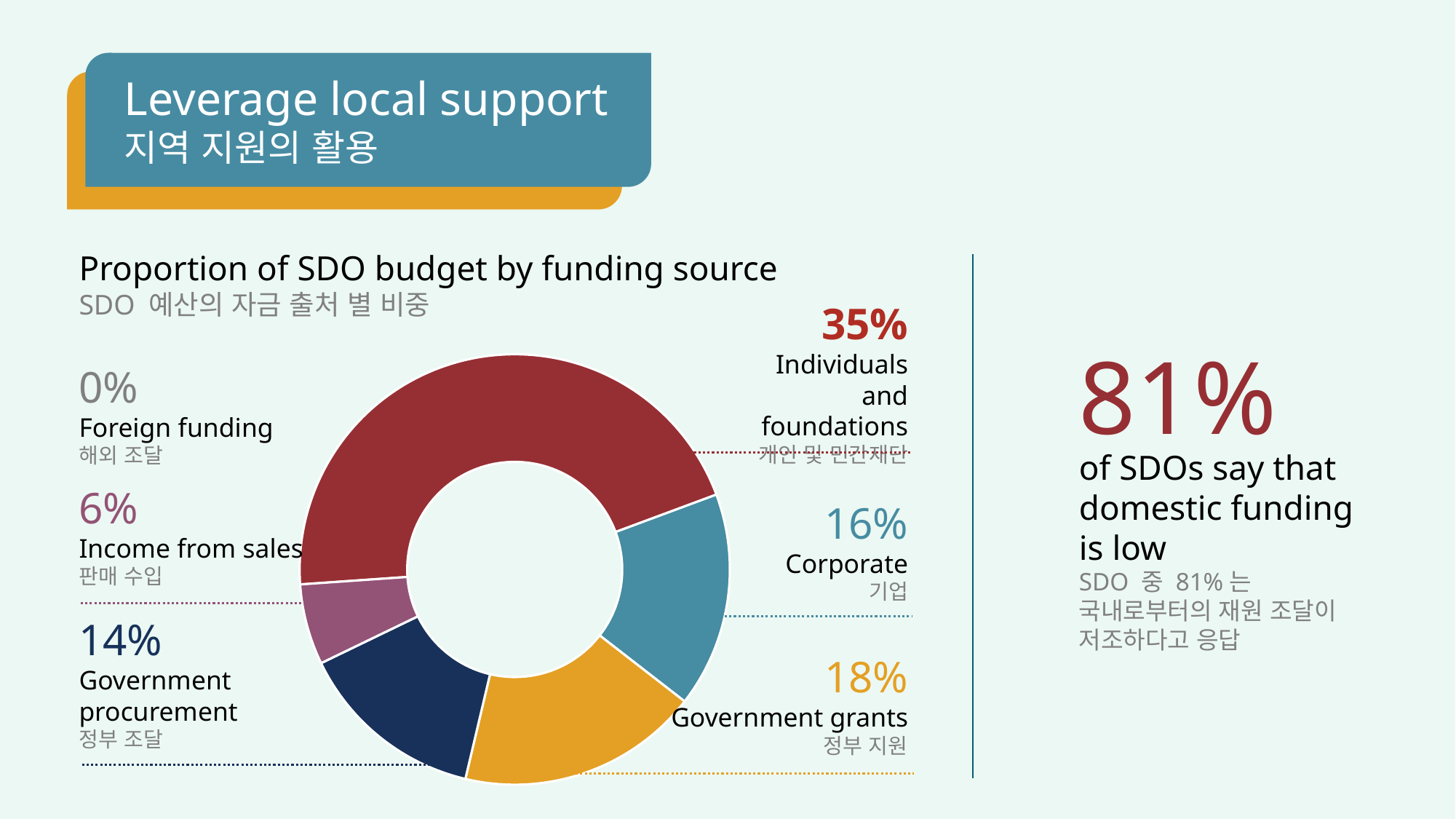
Which is larger: the share for government procurement or the share for income from sales? Government procurement What kind of chart is used to show the proportion of SDO budget by funding source? Doughnut chart What share of the SDO budget comes from corporate funding? 16% What share of the SDO budget comes from foreign funding? 0% Which funding source accounts for the smallest share of the SDO budget? Foreign funding What is the difference in percentage points between the shares for government grants and corporate funding? 2 percentage points What share of the SDO budget comes from government grants? 18% Which funding source accounts for the largest share of the SDO budget? Individuals and foundations What is the title of the chart on the slide? Proportion of SDO budget by funding source What share of the SDO budget comes from government procurement? 14% What share of the SDO budget comes from income from sales? 6% What share of the SDO budget comes from individuals and foundations? 35%